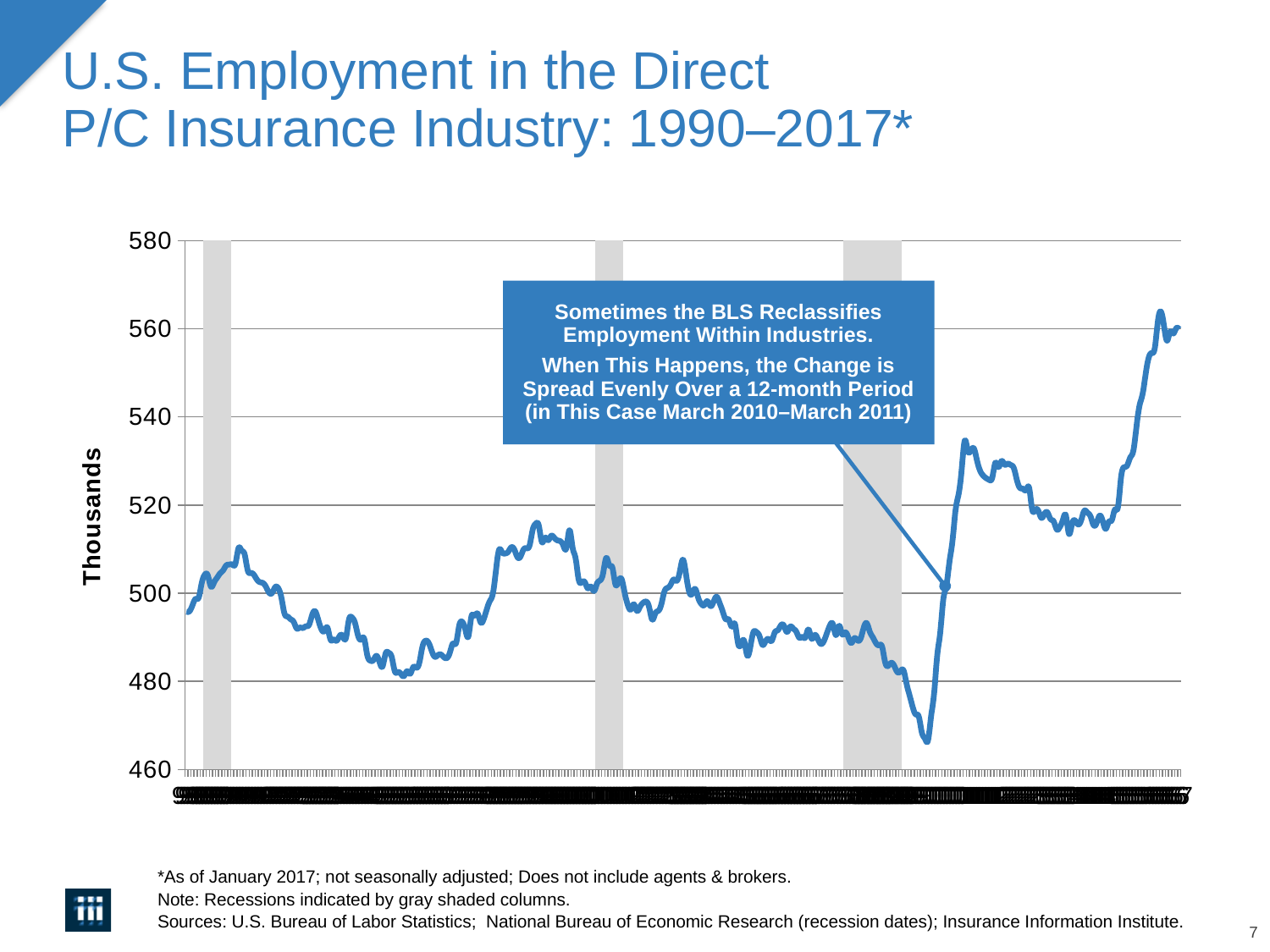
What is the label on the vertical axis of the chart? Thousands Is the lowest point of the line greater or less than 480? less Is the highest point of the line greater or less than 540? greater What is the highest value shown on the vertical axis? 580 Is the value at the end of the line larger or smaller than the value at the start of the line? larger Is the value at the left-hand start of the line greater or less than 500? less What kind of chart is shown on the slide? Line chart How many gray shaded recession columns appear on the chart? 3 Comparing the start of the line to its end, does employment rise or fall over the period shown? rise